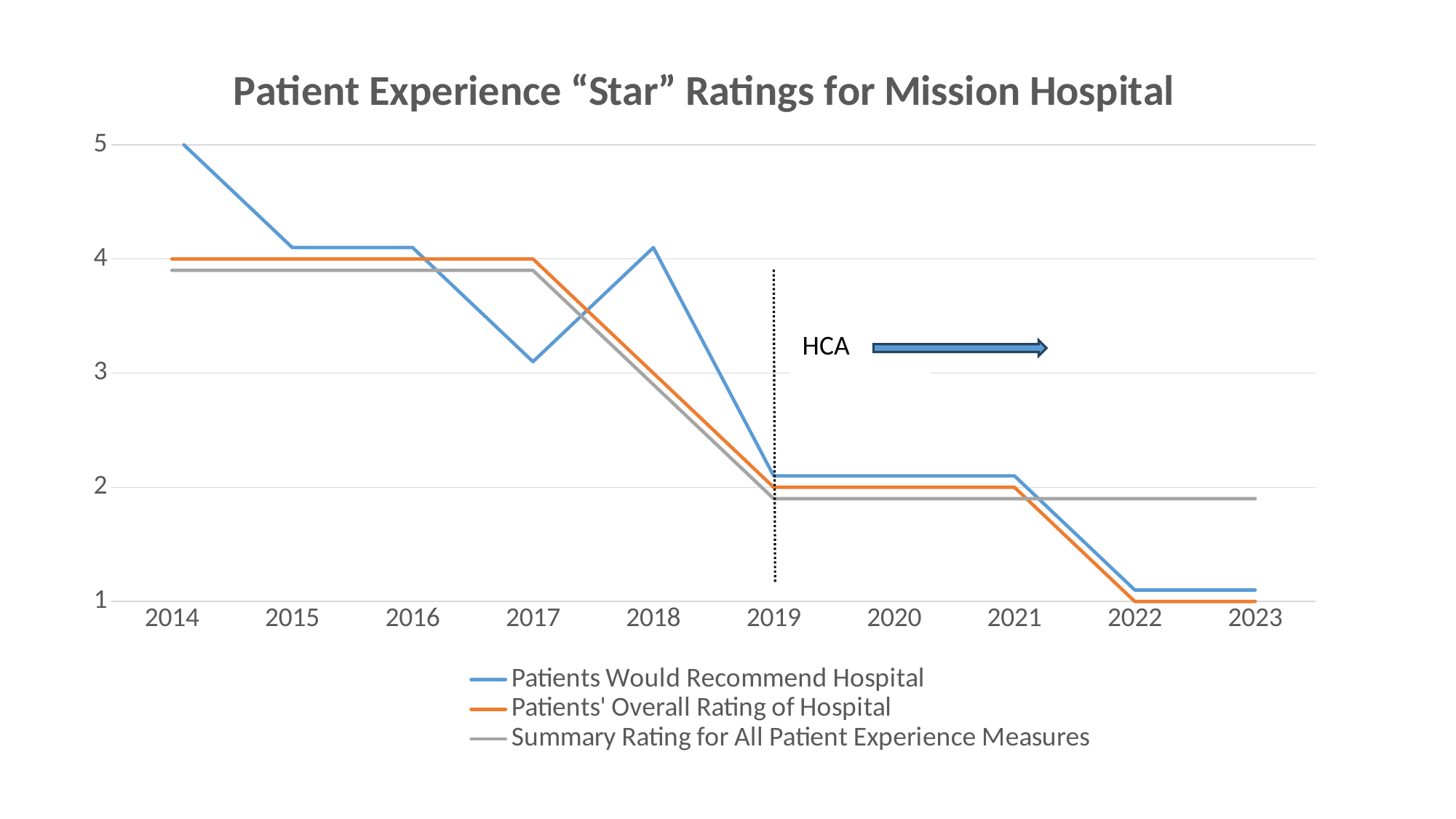
Is the value for Summary Rating for All Patient Experience Measures in 2023 greater or less than 2? less What kind of chart is shown on the slide? line chart Is the value for Patients Would Recommend Hospital in 2017 greater or less than 4? less What label appears next to the dotted vertical line at 2019? HCA Do the ratings generally rise or fall from 2014 to 2023? fall What is the value for Patients' Overall Rating of Hospital in 2023? 1 What is the value for Patients' Overall Rating of Hospital in 2015? 4 In which year is the Patients Would Recommend Hospital rating highest? 2014 How many years are shown on the x axis? 10 In 2018, which is larger: Patients Would Recommend Hospital or Patients' Overall Rating of Hospital? Patients Would Recommend Hospital How many series does the legend list? 3